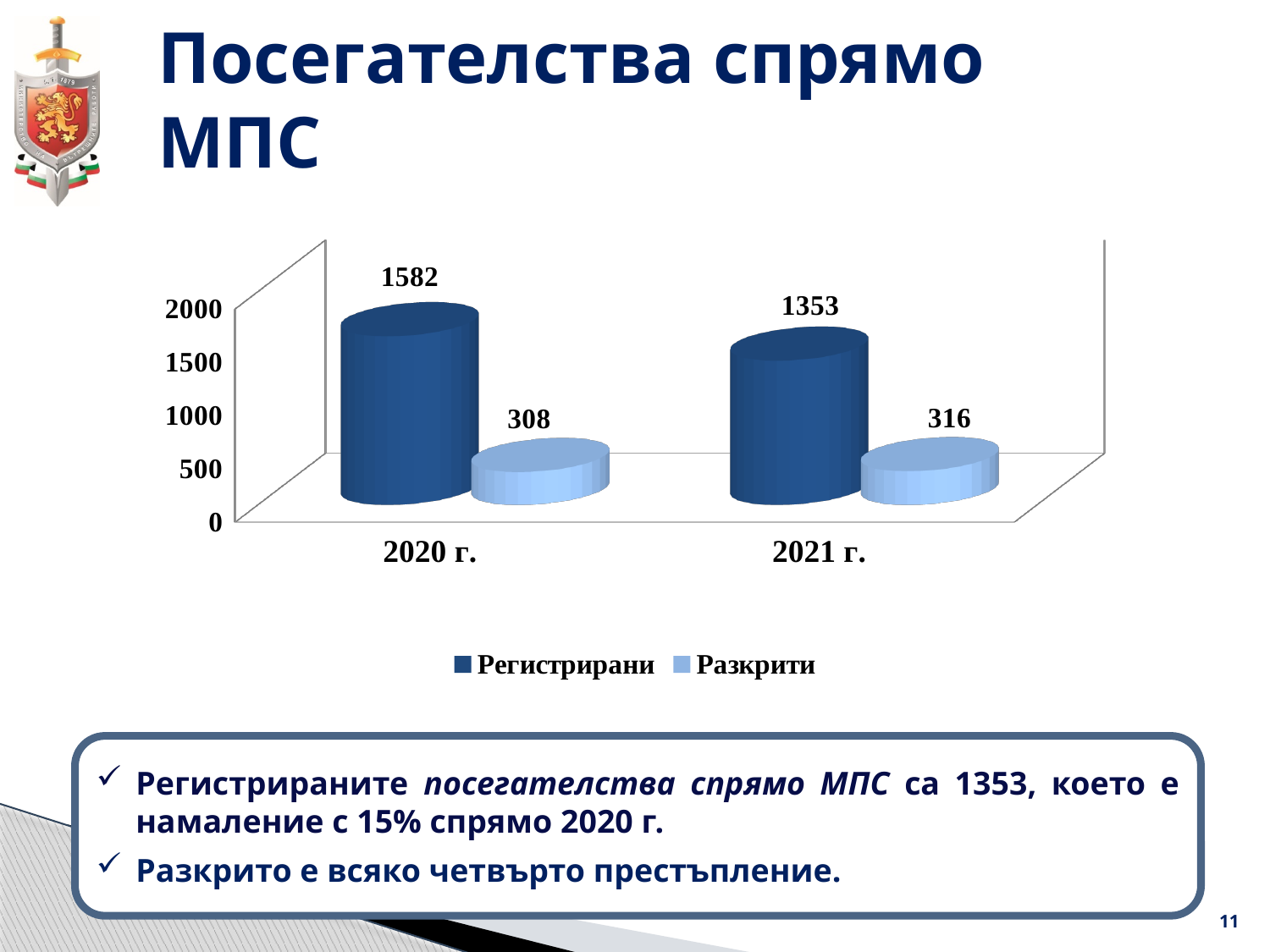
How many series does the legend list? 2 What is the value for Разкрити in 2020 г.? 308 Does the value for Регистрирани rise or fall from 2020 г. to 2021 г.? Fall What kind of chart is shown on the slide? Bar chart What is the value for Разкрити in 2021 г.? 316 What is the difference between Регистрирани in 2020 г. and in 2021 г.? 229 What is the value for Регистрирани in 2020 г.? 1582 Is the value for Регистрирани in 2021 г. greater or less than 1000? greater What is the value for Регистрирани in 2021 г.? 1353 Which year has the lower value for Разкрити? 2020 г. Which year has the higher value for Регистрирани? 2020 г. How many categories are shown on the x axis? 2